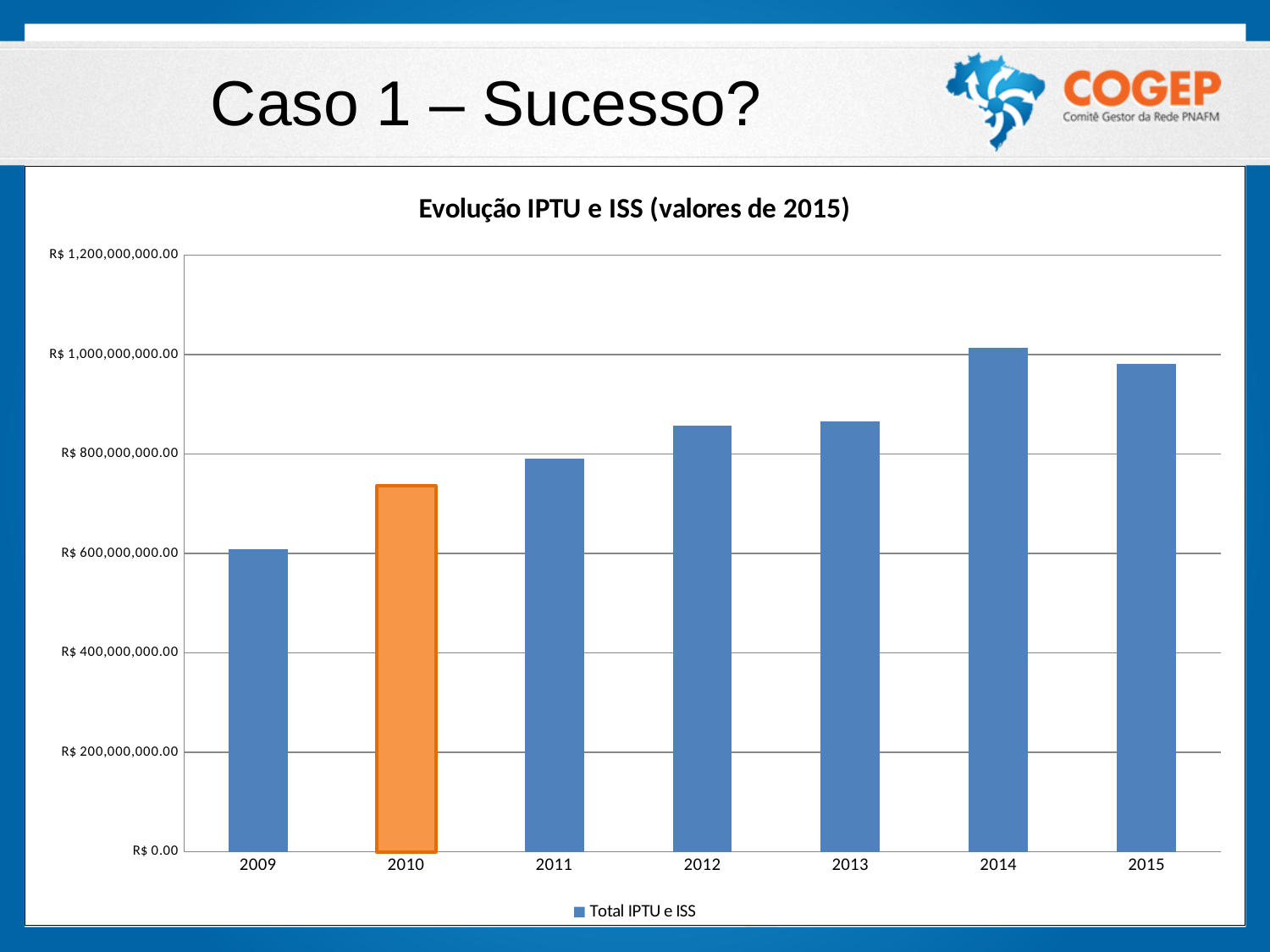
Is the value for 2012 greater or less than R$ 800,000,000.00? greater How many years are shown on the x axis of the chart? 7 Which year has the lowest value in the chart? 2009 Is the value for 2014 greater or less than R$ 1,000,000,000.00? greater Which year's bar is highlighted in orange? 2010 What is the title of the chart? Evolução IPTU e ISS (valores de 2015) How many series does the legend list? 1 Is the value for 2015 greater or less than R$ 1,000,000,000.00? less Which year has the highest value in the chart? 2014 Which year has the larger value, 2014 or 2015? 2014 What kind of chart is shown on the slide? bar chart